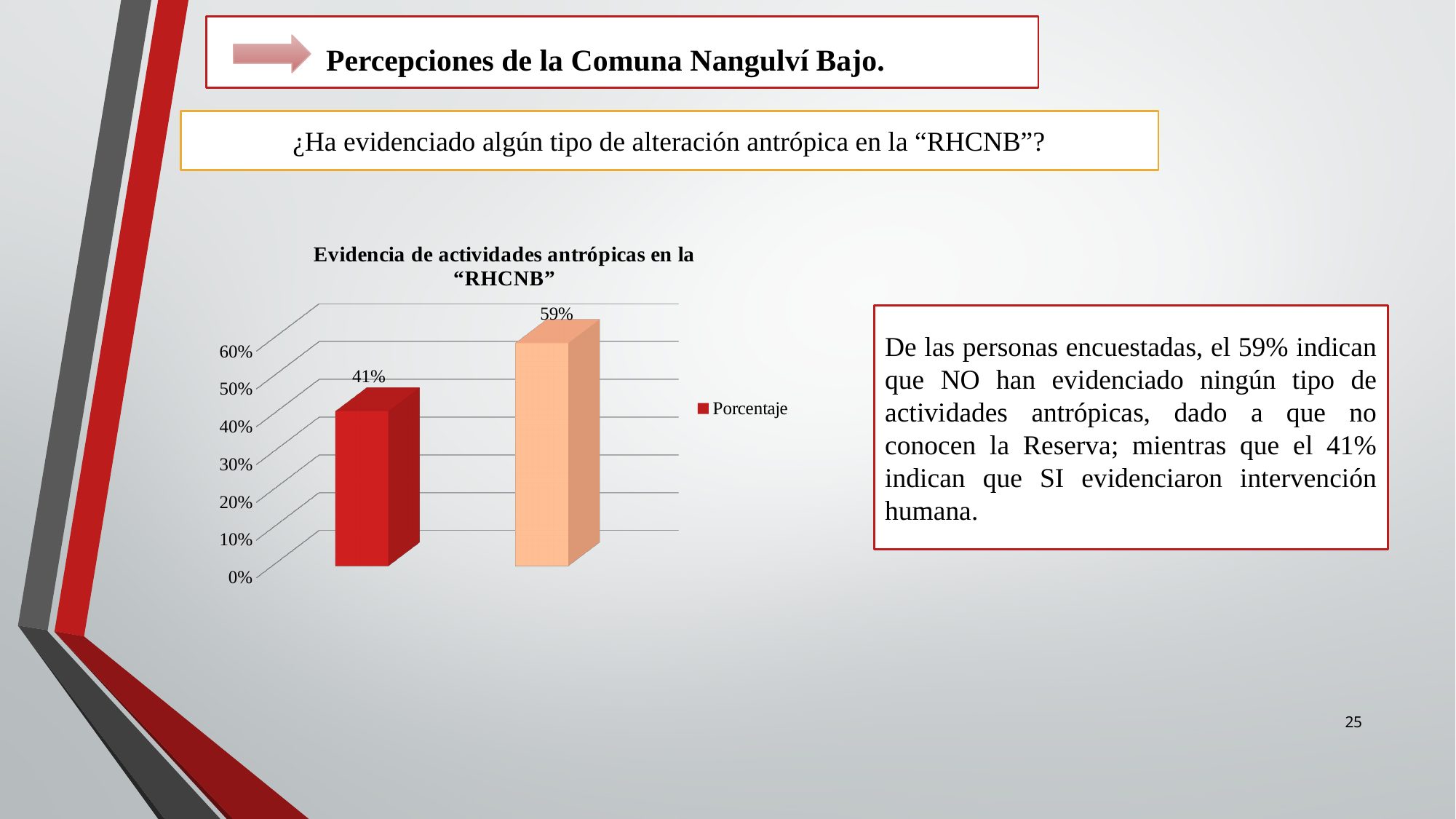
What kind of chart is shown on the slide? bar chart What is the highest value shown in the chart? 59% What is the title of the chart? Evidencia de actividades antrópicas en la "RHCNB" How many bars are plotted in the chart? 2 What value is shown on the red (left) bar of the chart? 41% What is the difference between the two bar values in the chart? 18% Is the value of the red (left) bar greater or less than 50%? less What is the name of the series in the chart legend? Porcentaje How many series does the chart legend list? 1 What is the lowest value shown in the chart? 41% What value is shown on the peach-coloured (right) bar of the chart? 59% Which bar has the higher value, the red (left) bar or the peach (right) bar? the peach (right) bar